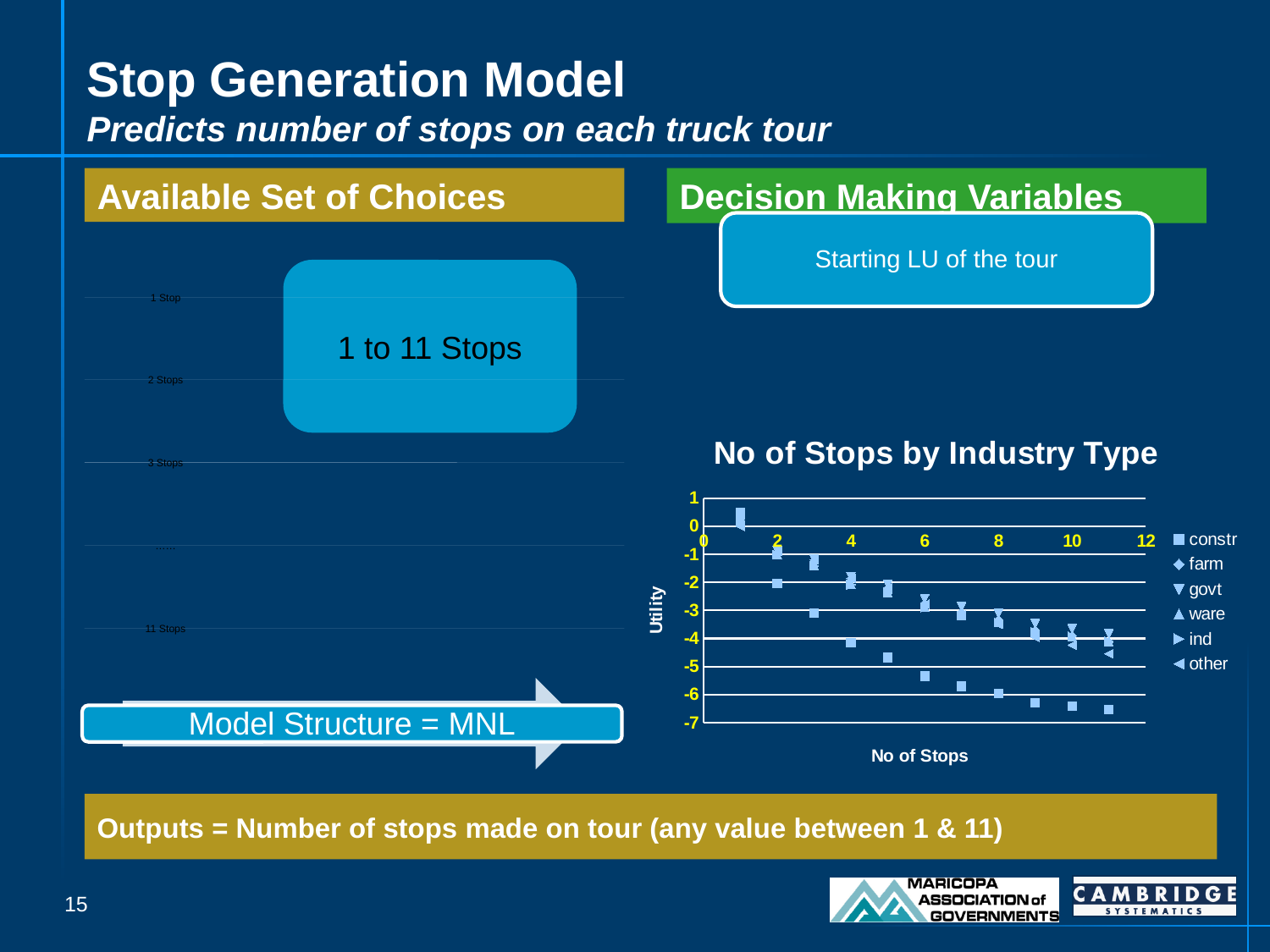
What kind of chart is 'No of Stops by Industry Type'? scatter chart What is the title of the chart on the right side of the slide? No of Stops by Industry Type How many series does the legend of the 'No of Stops by Industry Type' chart list? 6 In the 'No of Stops by Industry Type' chart, is the highest plotted utility value greater or less than 0? greater In the 'No of Stops by Industry Type' chart, is the lowest plotted utility value greater or less than -6? less In the 'No of Stops by Industry Type' chart, do the utility values generally rise or fall as the number of stops increases? fall In the 'No of Stops by Industry Type' chart, what label is on the vertical axis? Utility